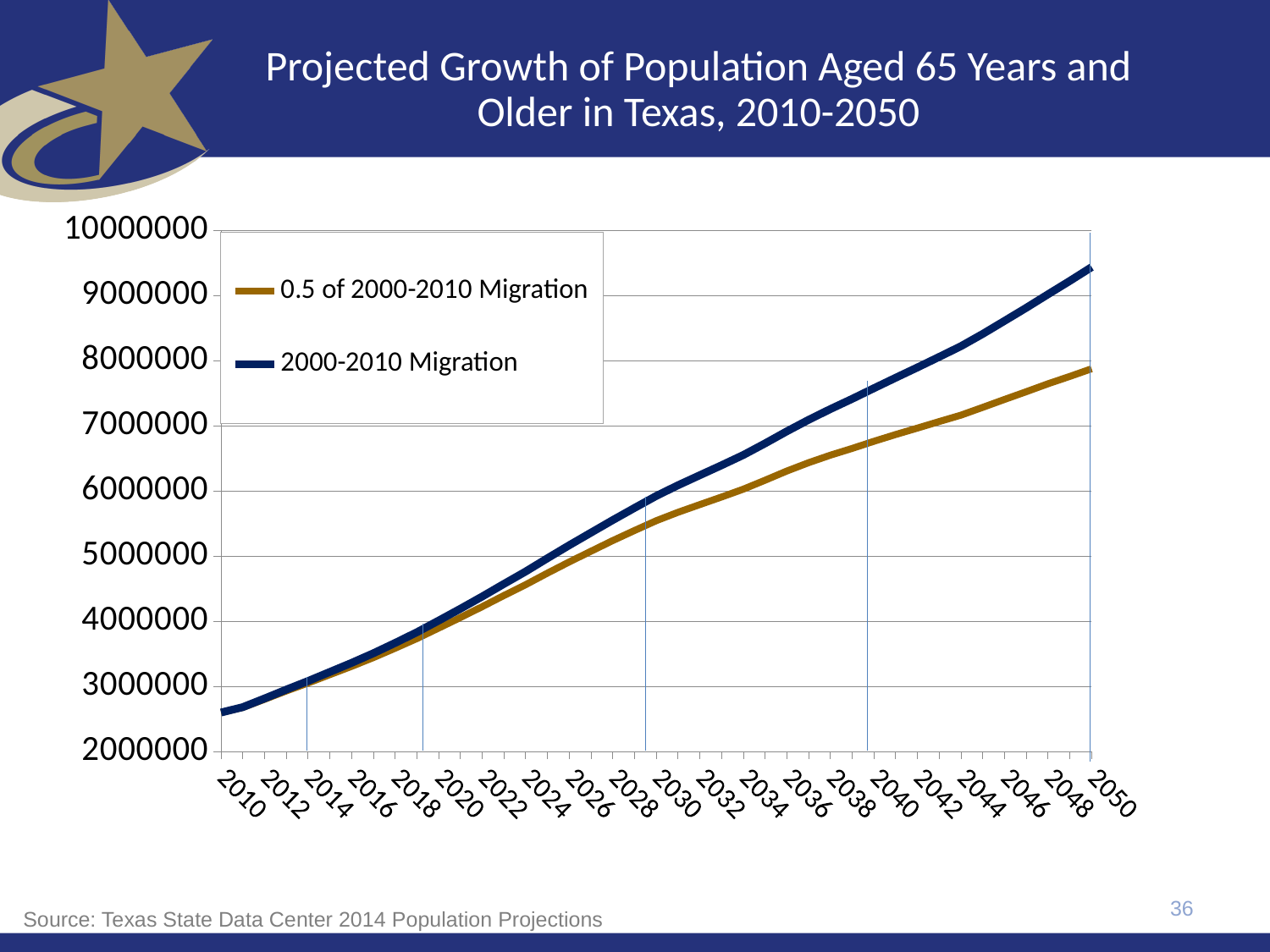
Is the value for 2000-2010 Migration in 2050 greater or less than 9000000? greater Is the value for 2000-2010 Migration in 2010 greater or less than 3000000? less How many series does the legend list? 2 What is the title of the chart? Projected Growth of Population Aged 65 Years and Older in Texas, 2010-2050 Do the values for the 2000-2010 Migration series rise or fall from 2010 to 2050? rise Is the value for 0.5 of 2000-2010 Migration in 2040 greater or less than 7000000? less In 2050, which series has the higher value? 2000-2010 Migration How many year labels are shown on the x axis? 21 What kind of chart is shown on the slide? line chart